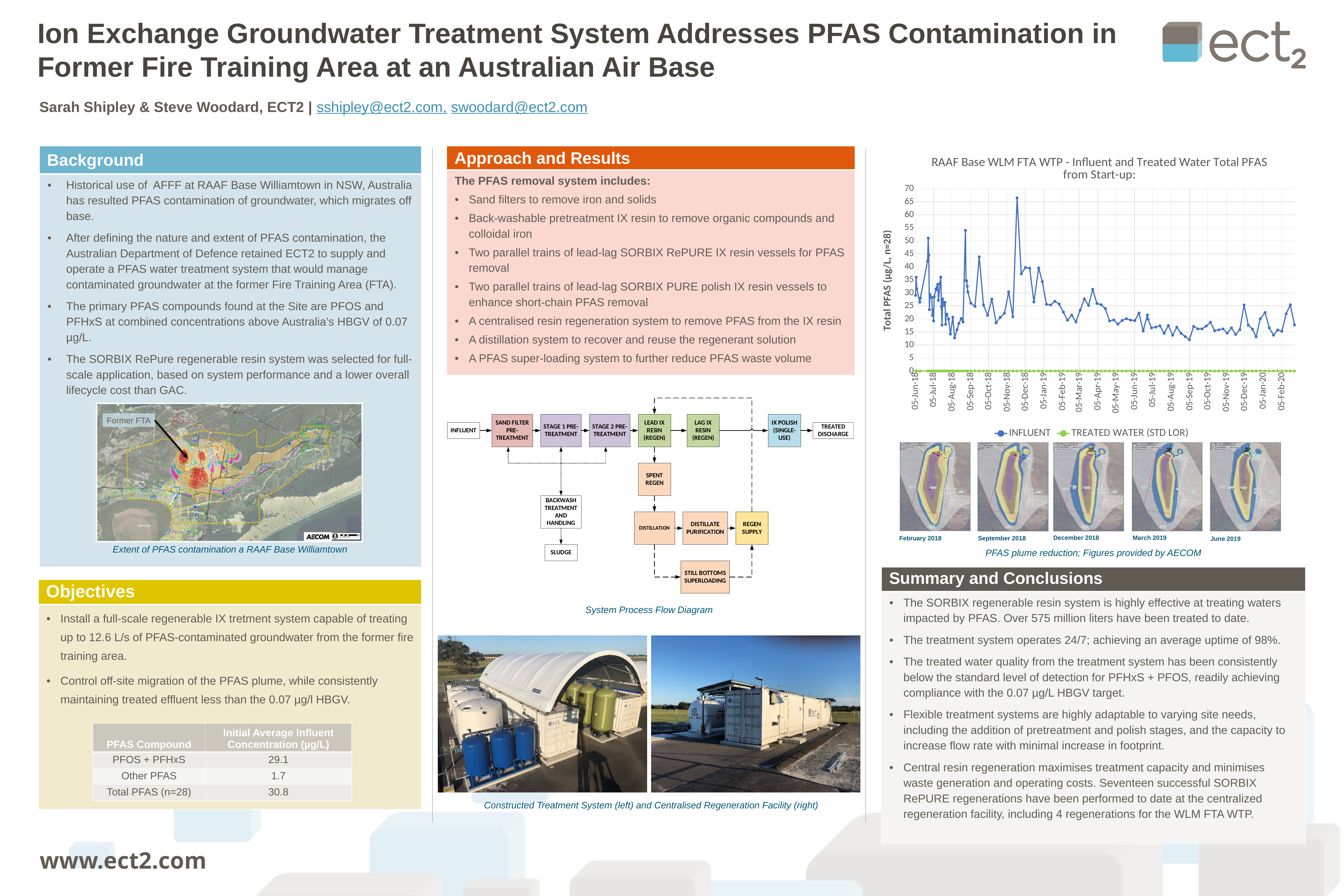
How many series does the legend of the line chart list? 2 What is the highest value shown on the y axis of the line chart? 70 Which series in the line chart has the higher values throughout, INFLUENT or TREATED WATER (STD LOR)? INFLUENT Do the INFLUENT values in the line chart generally rise or fall from 05-Jun-18 to 05-Feb-20? fall What are the two series named in the legend of the line chart? INFLUENT and TREATED WATER (STD LOR) What kind of chart is shown on the slide? line chart Is the INFLUENT value at 05-Jun-18 in the line chart greater or less than 20? greater Is the highest INFLUENT value in the line chart greater or less than 60? greater Is the INFLUENT value at 05-Feb-20 in the line chart greater or less than 30? less What is the title of the line chart? RAAF Base WLM FTA WTP - Influent and Treated Water Total PFAS from Start-up: